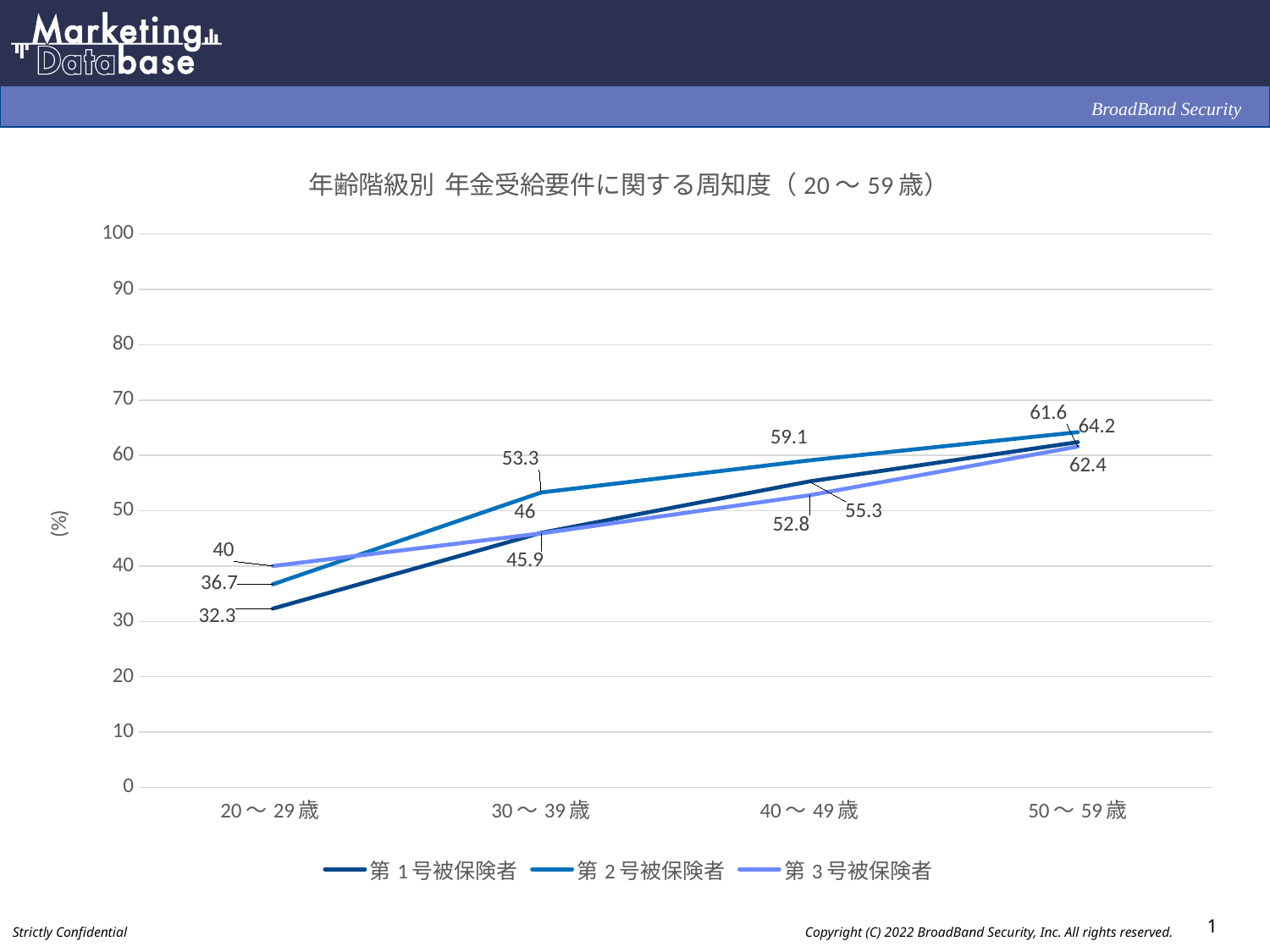
What is the value for 第3号被保険者 in the 20～29歳 group? 40 Does the 第2号被保険者 line rise or fall from 20～29歳 to 50～59歳? Rises How many age groups are plotted along the x axis? 4 What is the value for 第1号被保険者 in the 20～29歳 group? 32.3 What kind of chart is shown on the slide? Line chart What is the value for 第2号被保険者 in the 30～39歳 group? 53.3 What is the value for 第2号被保険者 in the 40～49歳 group? 59.1 What is the difference between 第2号被保険者 and 第3号被保険者 in the 40～49歳 group? 6.3 What is the value for 第2号被保険者 in the 50～59歳 group? 64.2 How many series does the legend list? 3 In the 40～49歳 group, which is larger: 第1号被保険者 or 第3号被保険者? 第1号被保険者 Which series has the lowest value in the 20～29歳 group? 第1号被保険者